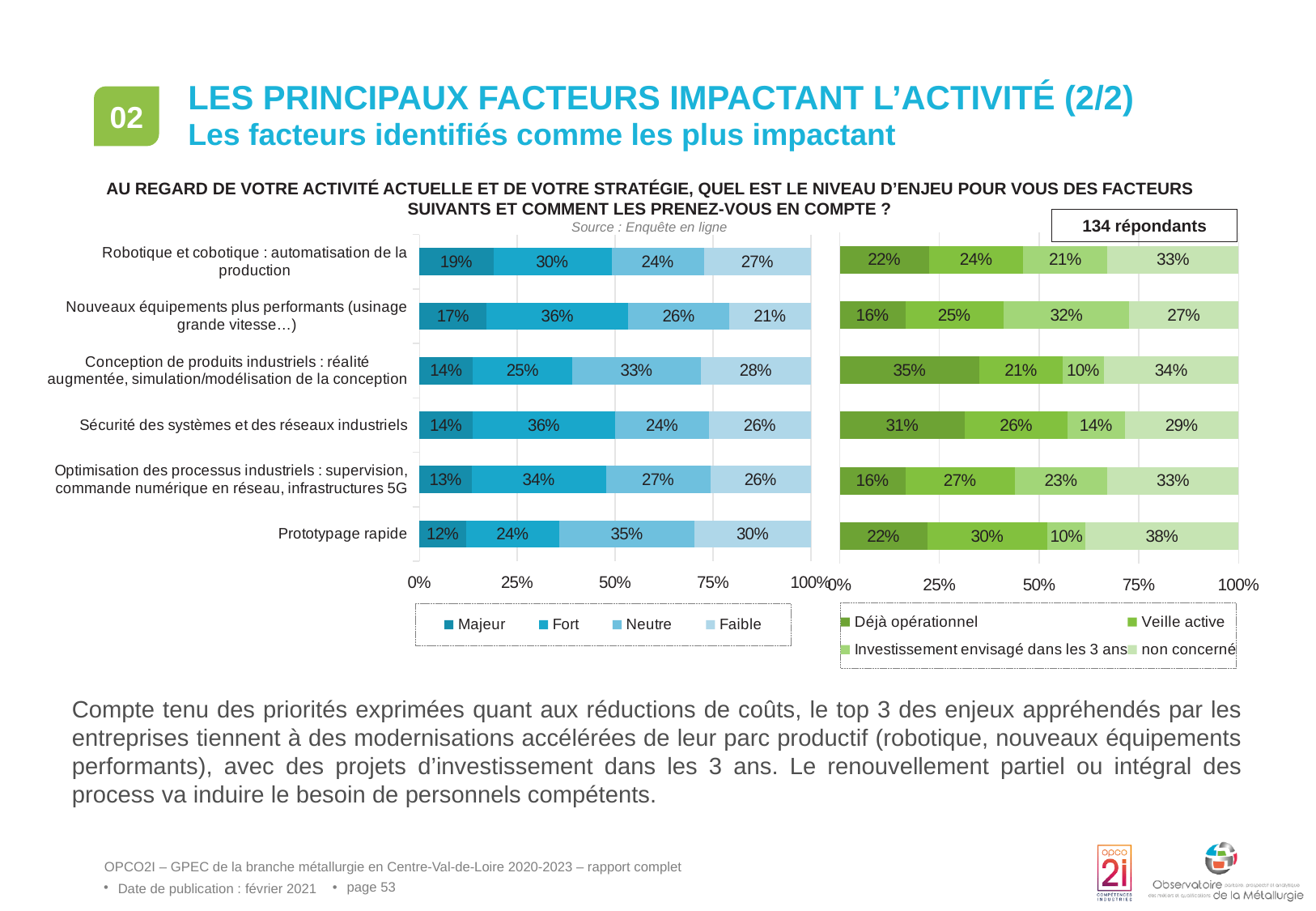
In the left chart, which category has the lowest 'Majeur' value? Prototypage rapide In the left chart, what is the 'Majeur' value for 'Robotique et cobotique : automatisation de la production'? 19% How many respondents does the slide indicate for the survey? 134 répondants How many series does the legend of the right chart list? 4 In the right chart, what is the difference between the 'Déjà opérationnel' values for 'Conception de produits industriels' and 'Nouveaux équipements plus performants'? 19% In the right chart, what is the total of the stacked bar for 'Prototypage rapide'? 100% How many categories are shown in the left chart? 6 In the right chart, which category has the highest 'non concerné' value? Prototypage rapide In the left chart, which category has the highest 'Majeur' value? Robotique et cobotique : automatisation de la production In the left chart, is the 'Fort' value larger for 'Nouveaux équipements plus performants' or for 'Prototypage rapide'? Nouveaux équipements plus performants In the right chart, what is the 'Déjà opérationnel' value for 'Sécurité des systèmes et des réseaux industriels'? 31% What kind of chart is the left chart? Stacked bar chart